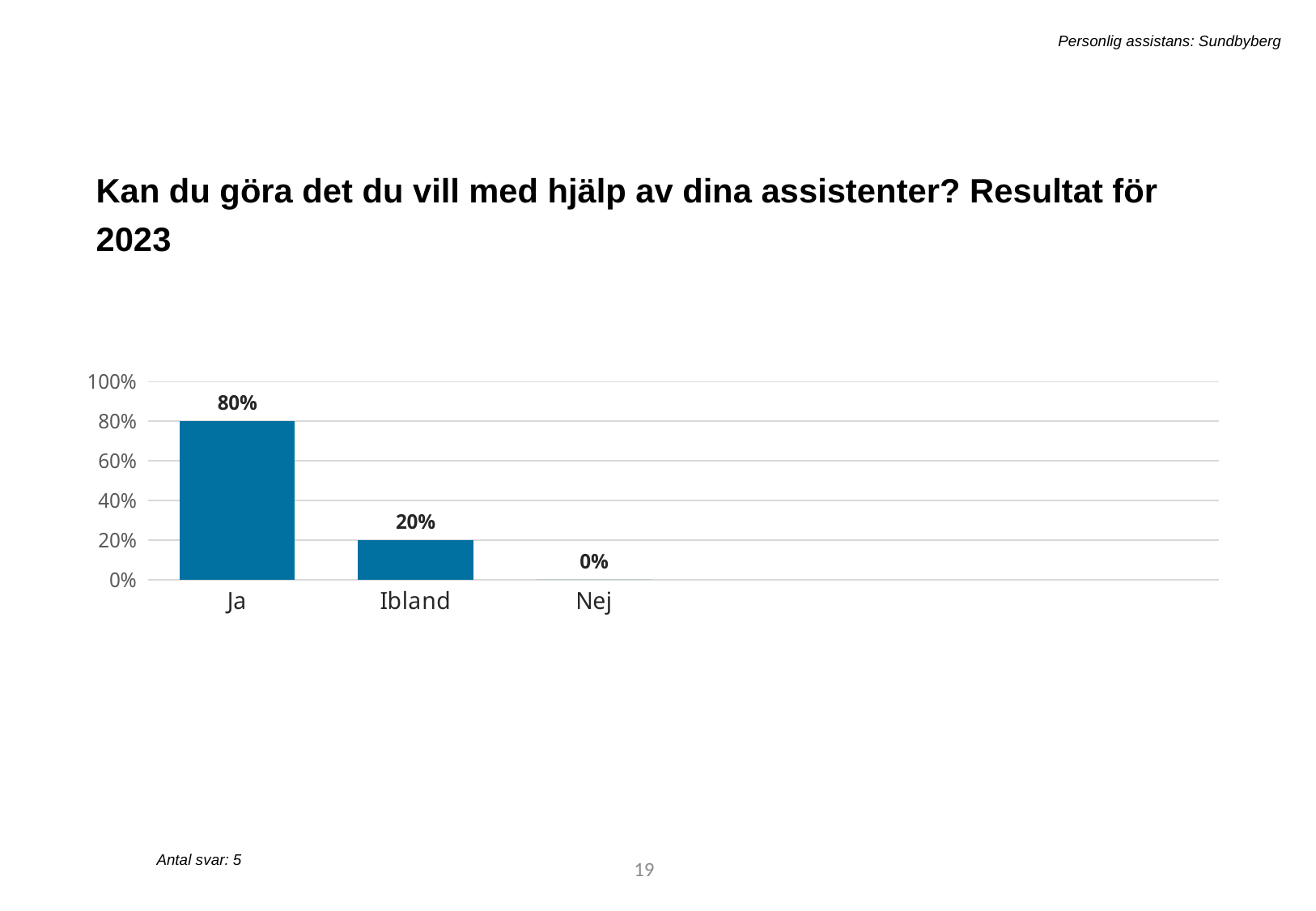
What is the value for Ja? 80% Which is larger, the value for Ibland or the value for Nej? Ibland What is the value for Nej? 0% How many responses (Antal svar) does the slide report? 5 Which category has the lowest value? Nej How many categories are shown on the x axis? 3 What is the difference between the values for Ja and Ibland? 60% What kind of chart is shown on the slide? bar chart Do the values rise or fall from Ja to Nej along the x axis? fall Is the value for Ja greater or less than 60%? greater Which category has the highest value? Ja What is the value for Ibland? 20%